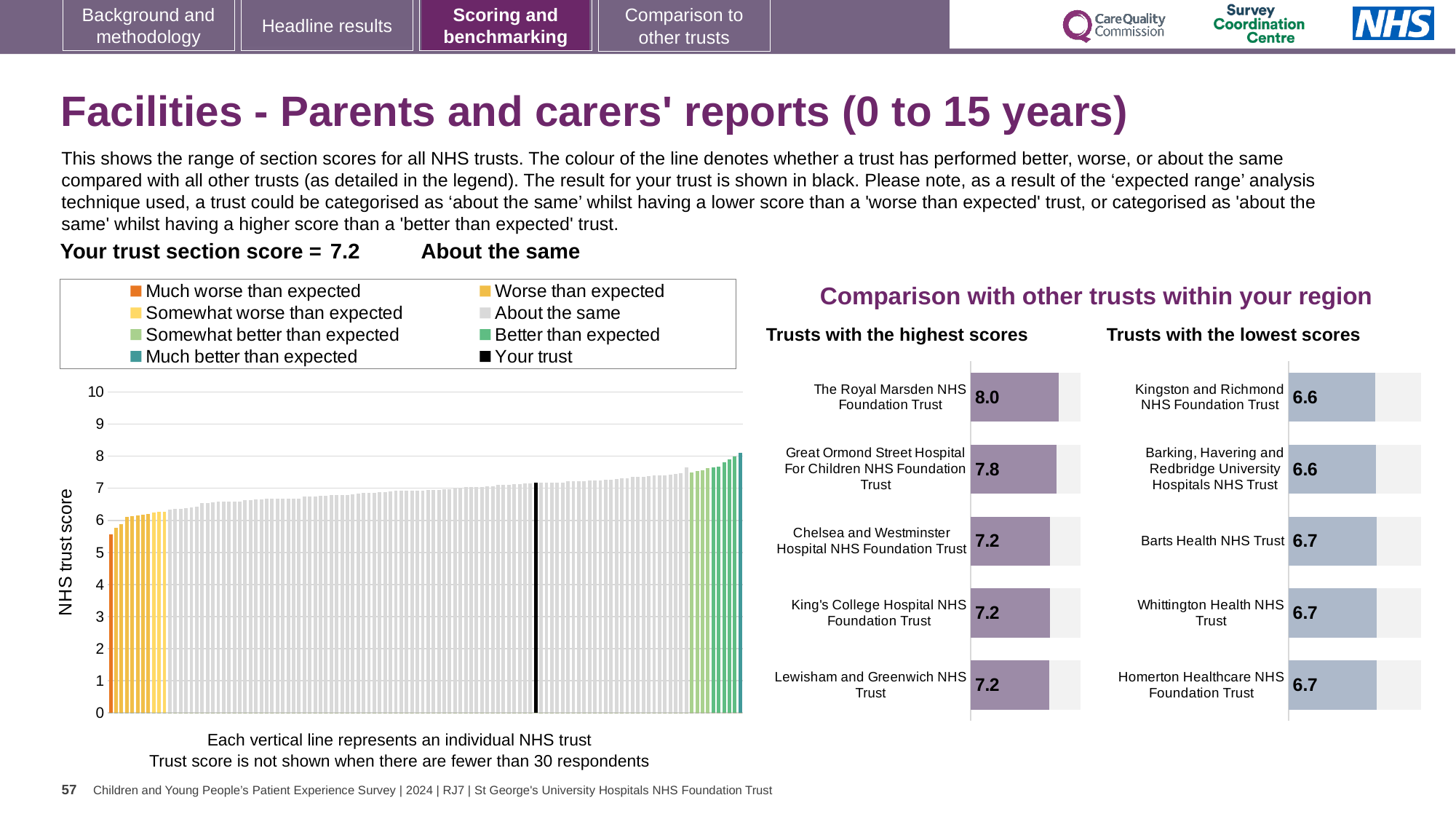
In the 'Trusts with the highest scores' chart, what is the difference between the scores of The Royal Marsden NHS Foundation Trust and Great Ormond Street Hospital For Children NHS Foundation Trust? 0.2 In the 'Trusts with the lowest scores' chart, which has the larger score: Barts Health NHS Trust or Kingston and Richmond NHS Foundation Trust? Barts Health NHS Trust In the 'Trusts with the lowest scores' chart, what is the score for Kingston and Richmond NHS Foundation Trust? 6.6 In the 'Trusts with the highest scores' chart, what is the score for Great Ormond Street Hospital For Children NHS Foundation Trust? 7.8 In the main chart on the left, do the bar values rise or fall from left to right? rise In the 'Trusts with the lowest scores' chart, what is the score for Barts Health NHS Trust? 6.7 In the main chart on the left, is the value for the black 'Your trust' bar greater or less than 7? greater In the 'Trusts with the highest scores' chart, what is the score for The Royal Marsden NHS Foundation Trust? 8.0 In the 'Trusts with the highest scores' chart, which trust has the highest score? The Royal Marsden NHS Foundation Trust How many trusts are shown in the 'Trusts with the lowest scores' chart? 5 In the main chart on the left, is the value for the leftmost (lowest) bar greater or less than 6? less What is the y-axis label of the main chart on the left? NHS trust score